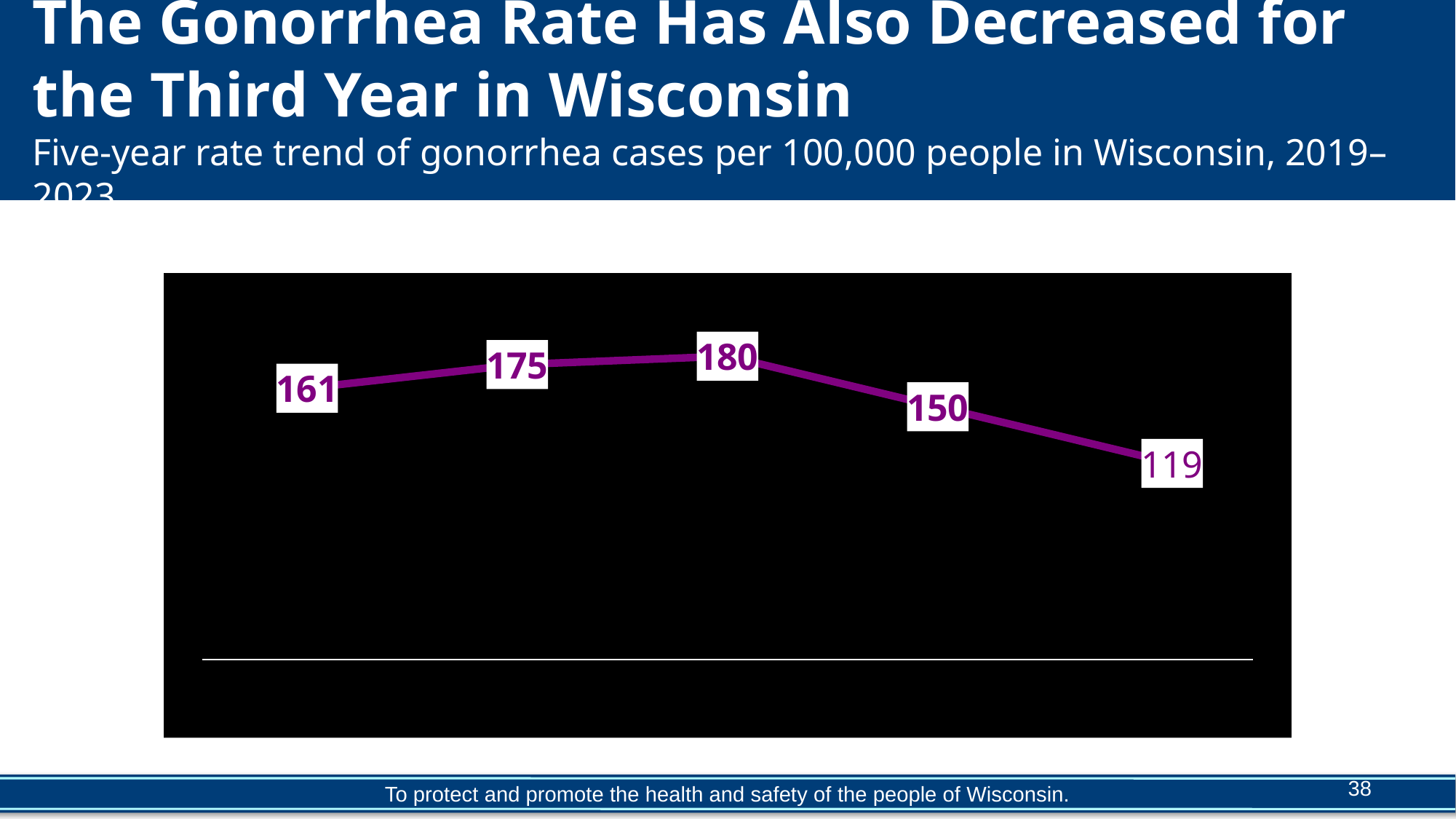
Which is larger, the second data point or the fourth data point? the second data point (175) What is the value of the last (rightmost) data point? 119 What colour is the line in the chart? purple What is the difference between the fourth data point (150) and the last data point (119)? 31 Do the values rise or fall over the last three data points of the line? fall What is the highest value shown on the line? 180 What is the value of the third data point? 180 What type of chart is shown on the slide? line chart How many data points are plotted on the line? 5 What is the lowest value shown on the line? 119 What is the difference between the highest value (180) and the lowest value (119)? 61 What is the value of the first (leftmost) data point? 161